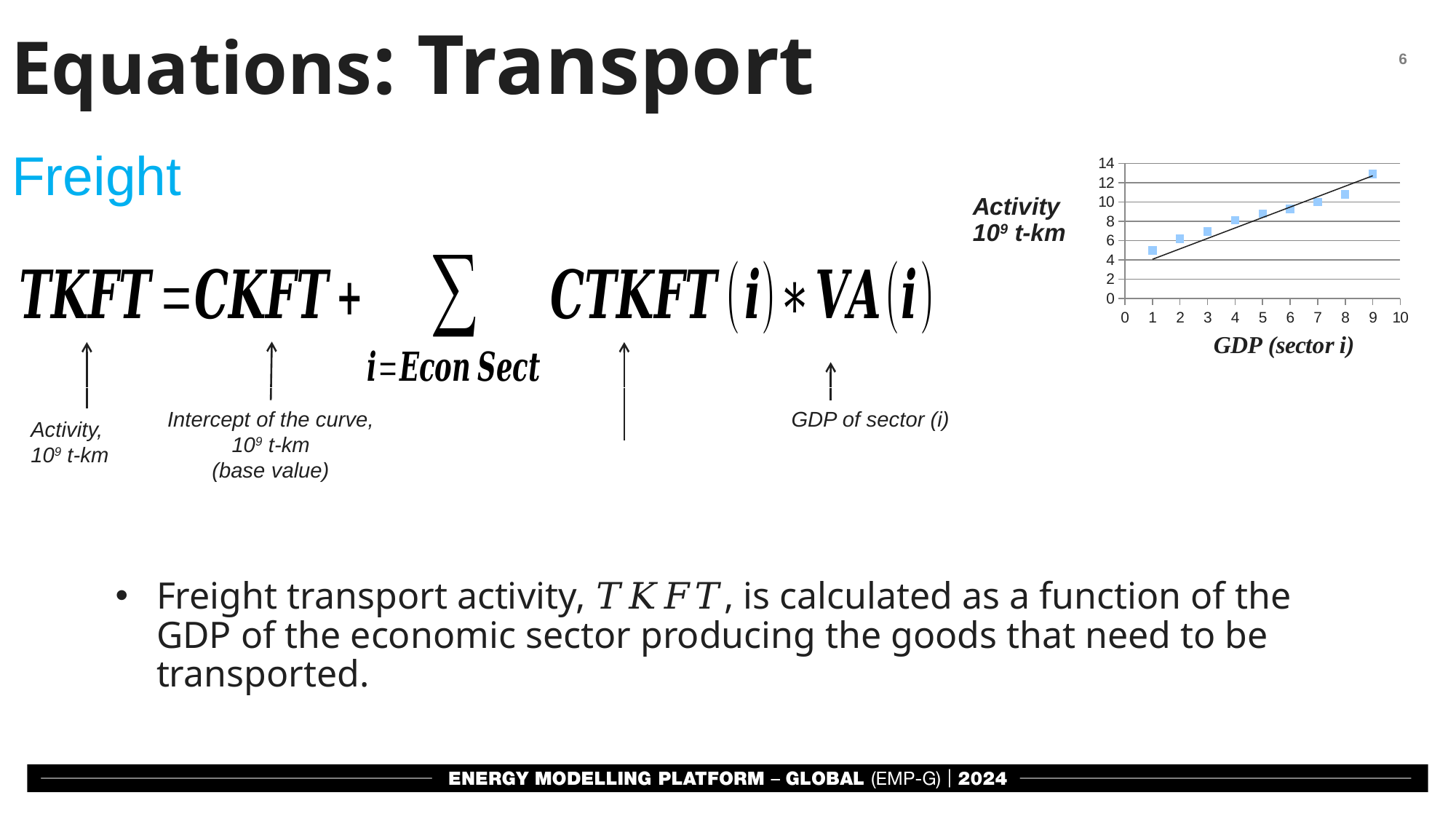
What kind of chart is shown on the slide? scatter chart Do the plotted activity values rise or fall as GDP (sector i) increases along the x axis? rise Which has the larger activity value: the point at GDP (sector i) = 3 or the point at GDP (sector i) = 7? GDP (sector i) = 7 Is the activity value at GDP (sector i) = 1 greater or less than 6? less At which GDP (sector i) value is the plotted activity lowest? 1 What is the maximum value shown on the y axis of the chart? 14 How many data points are plotted in the chart? 9 Is the activity value at GDP (sector i) = 9 greater or less than 12? greater Is the activity value at GDP (sector i) = 8 greater or less than 10? greater At which GDP (sector i) value is the plotted activity highest? 9 What is the label of the x axis of the chart? GDP (sector i)